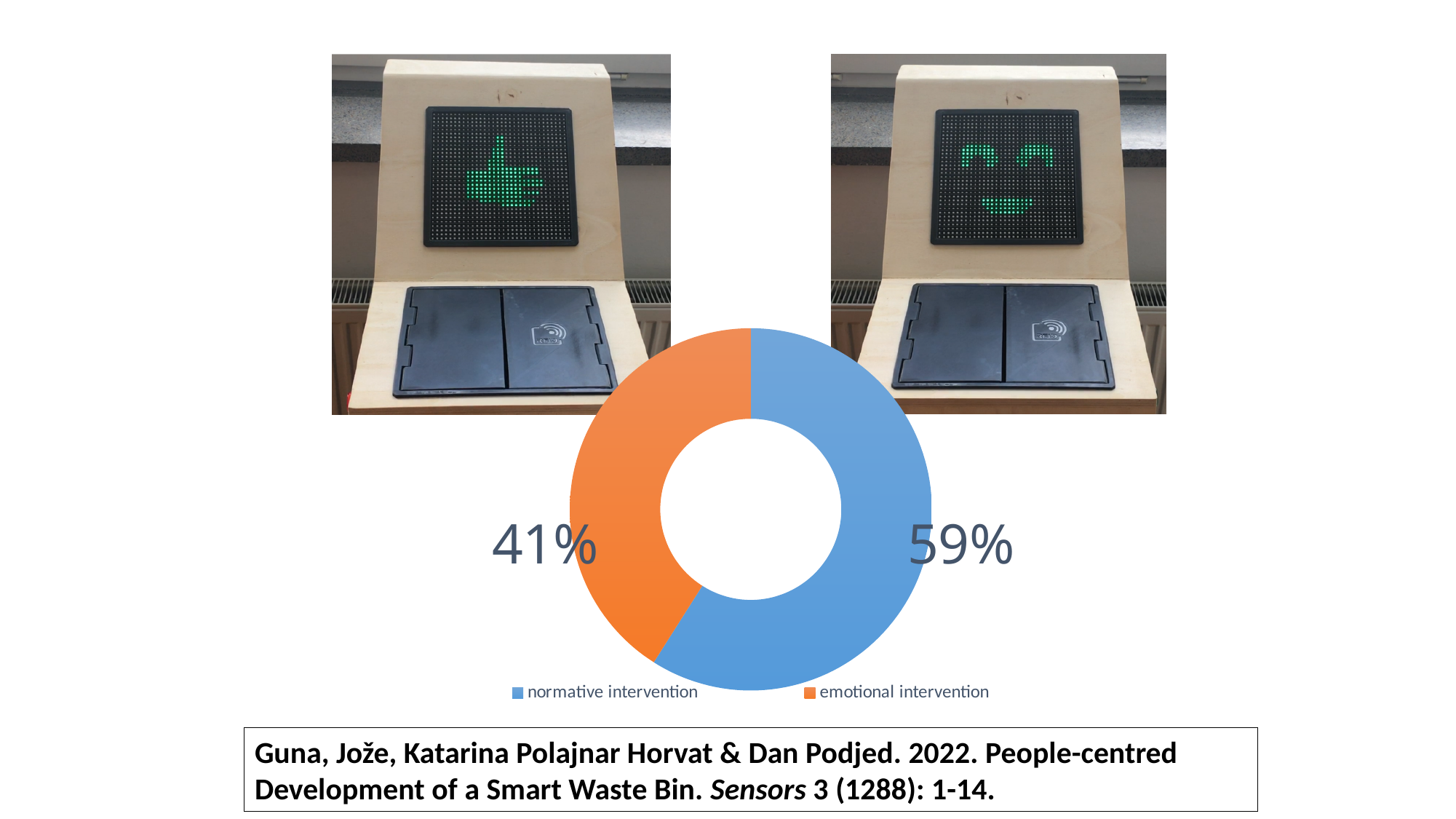
Which category has the smallest share in the chart? emotional intervention What share of the chart does normative intervention account for? 59% What kind of chart is shown on the slide? Doughnut (pie) chart What share of the chart does emotional intervention account for? 41% What is the difference in percentage points between normative intervention and emotional intervention? 18 percentage points What colour represents normative intervention in the chart? Blue What colour represents emotional intervention in the chart? Orange How many entries does the legend list? 2 Is the share for normative intervention greater or less than 50%? greater How many categories does the chart show? 2 Which is larger, the share for normative intervention or the share for emotional intervention? normative intervention Which category has the largest share in the chart? normative intervention